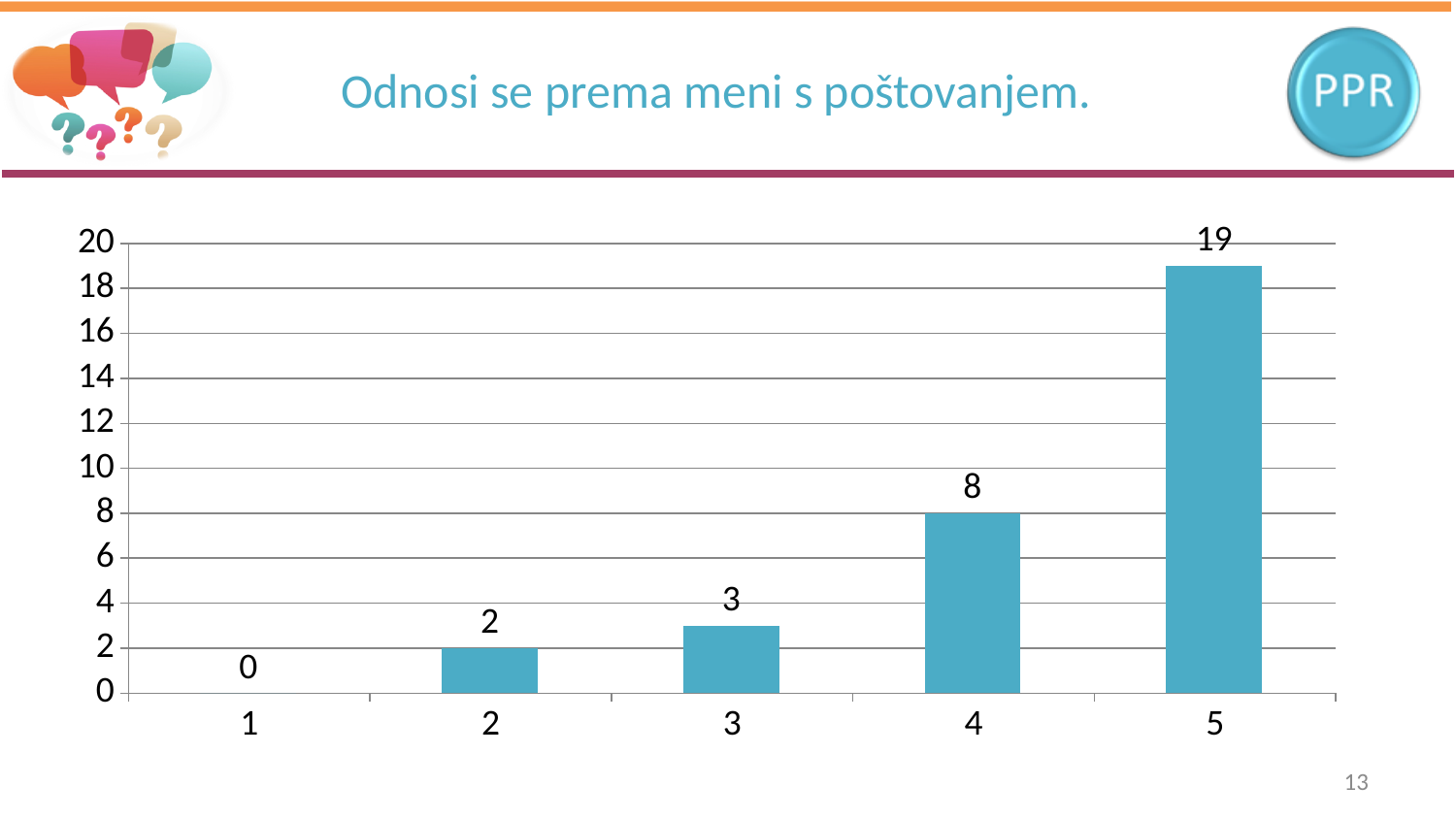
What is the value for category 4? 8 What is the value for category 1? 0 How many categories are shown on the x axis? 5 What kind of chart is shown on the slide? bar chart Which category has the lowest value? 1 Do the values rise or fall from category 1 to category 5? rise What is the difference between the values for categories 5 and 4? 11 Is the value for category 5 greater or less than 10? greater Which category has the highest value? 5 Which is larger, the value for category 2 or category 3? category 3 What is the value for category 5? 19 What is the title of the slide above the chart? Odnosi se prema meni s poštovanjem.